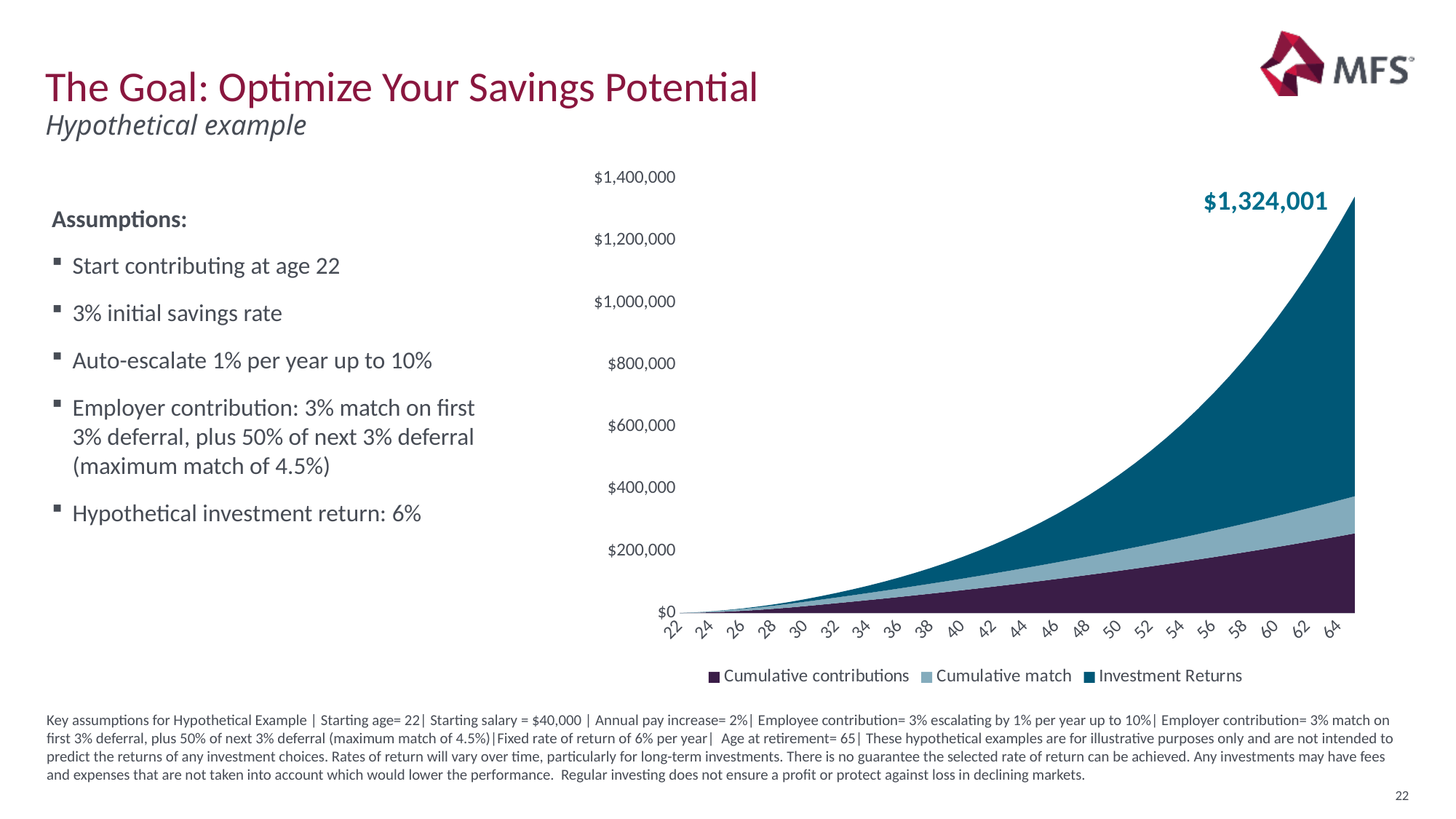
What value is printed as the data label at the right end of the chart? $1,324,001 What kind of chart is shown on the slide? Area chart Is the total stacked value at age 64 greater or less than $1,200,000? greater At the right end of the chart, which series accounts for the smallest portion of the stack? Cumulative match What are the three legend entries of the chart? Cumulative contributions, Cumulative match, Investment Returns Is the total stacked value at age 56 greater or less than $600,000? greater How many series does the chart legend list? 3 Do the stacked values rise or fall as age increases along the x axis? Rise How many age labels are shown along the x axis? 22 At age 64, which is larger: Investment Returns or Cumulative contributions? Investment Returns At the right end of the chart, which series accounts for the largest portion of the stack? Investment Returns